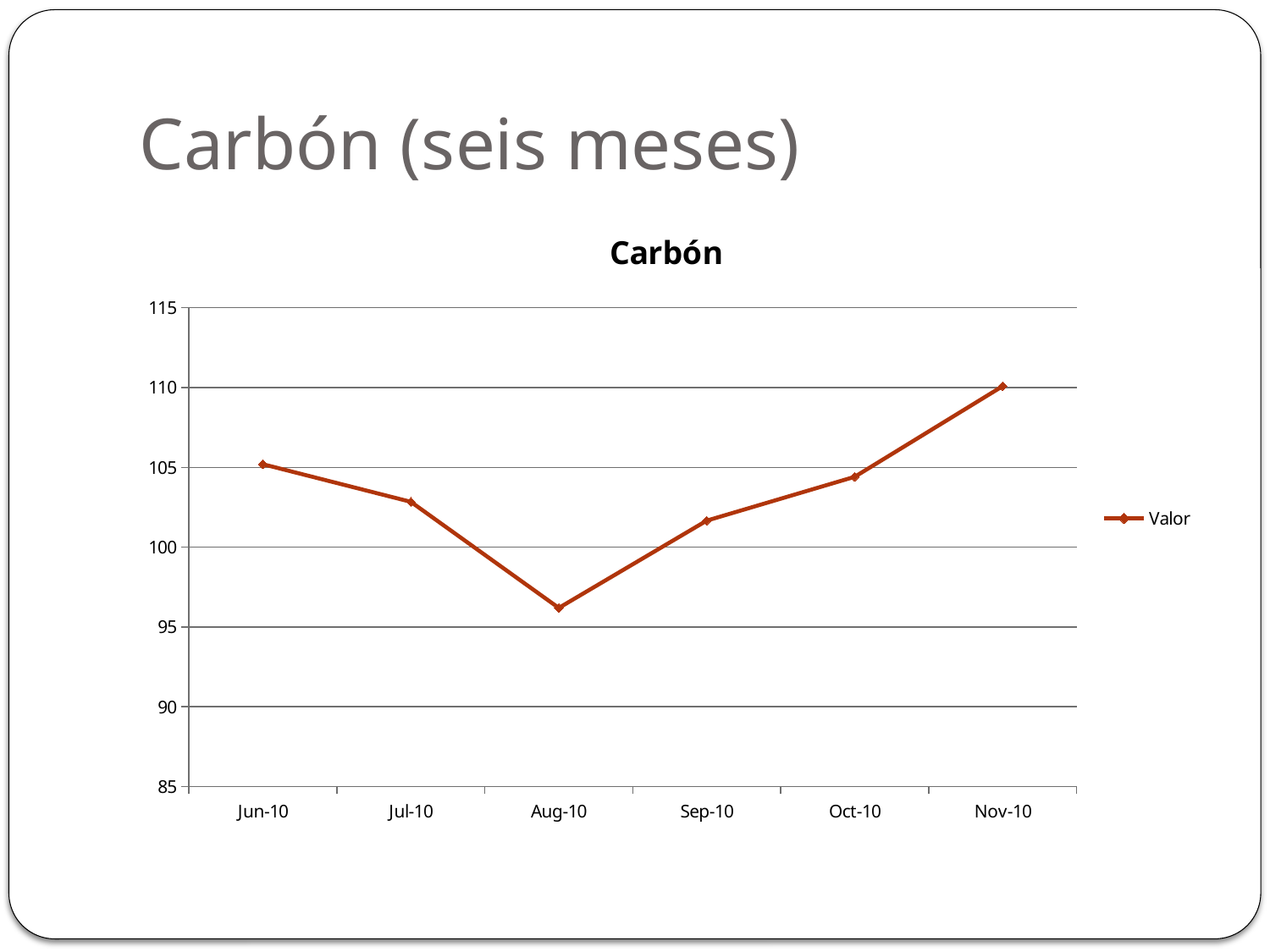
What kind of chart is shown on the slide? line chart Does the value rise or fall from Aug-10 to Nov-10? rise What is the title of the chart? Carbón How many months are plotted on the x axis? 6 Which month has the highest value? Nov-10 Is the value for Oct-10 greater or less than 105? less What is the name of the series shown in the legend? Valor How many series does the legend list? 1 Which month has the lowest value? Aug-10 Is the value for Aug-10 greater or less than 100? less Which is larger, the value for Jul-10 or the value for Sep-10? Jul-10